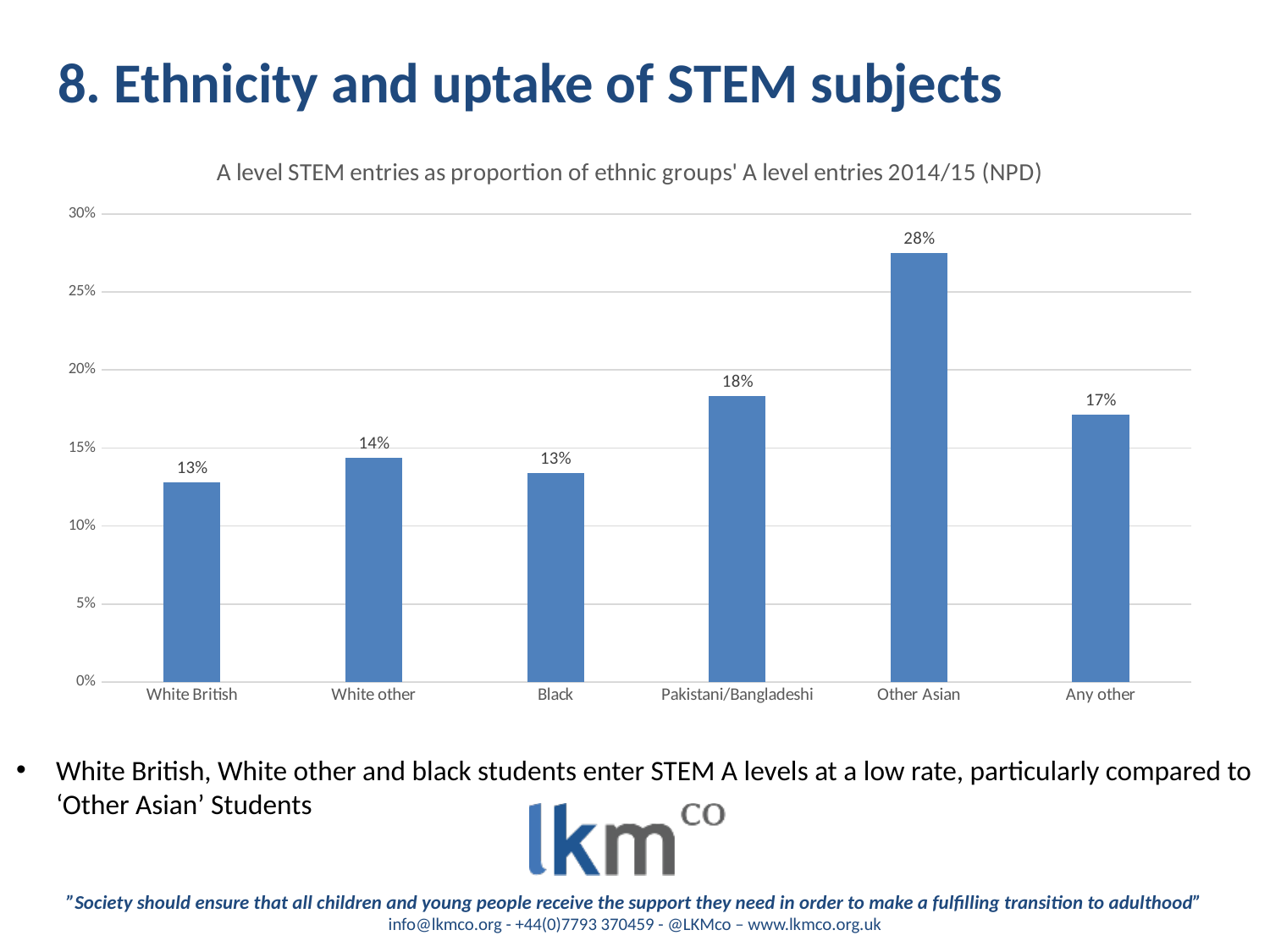
What is the value for White other? 14% What is the value for Pakistani/Bangladeshi? 18% Which ethnic group has the highest proportion of A level STEM entries? Other Asian Is the value for Other Asian greater or less than 25%? greater What is the value for Any other? 17% Which is larger, the value for Other Asian or the value for Pakistani/Bangladeshi? Other Asian What is the difference between the values for Pakistani/Bangladeshi and Any other? 1 percentage point What is the value for Other Asian? 28% What kind of chart is shown on the slide? Bar chart How many ethnic groups are shown on the chart? 6 Is the value for Black greater or less than 15%? less What is the difference between the values for Other Asian and White British? 15 percentage points